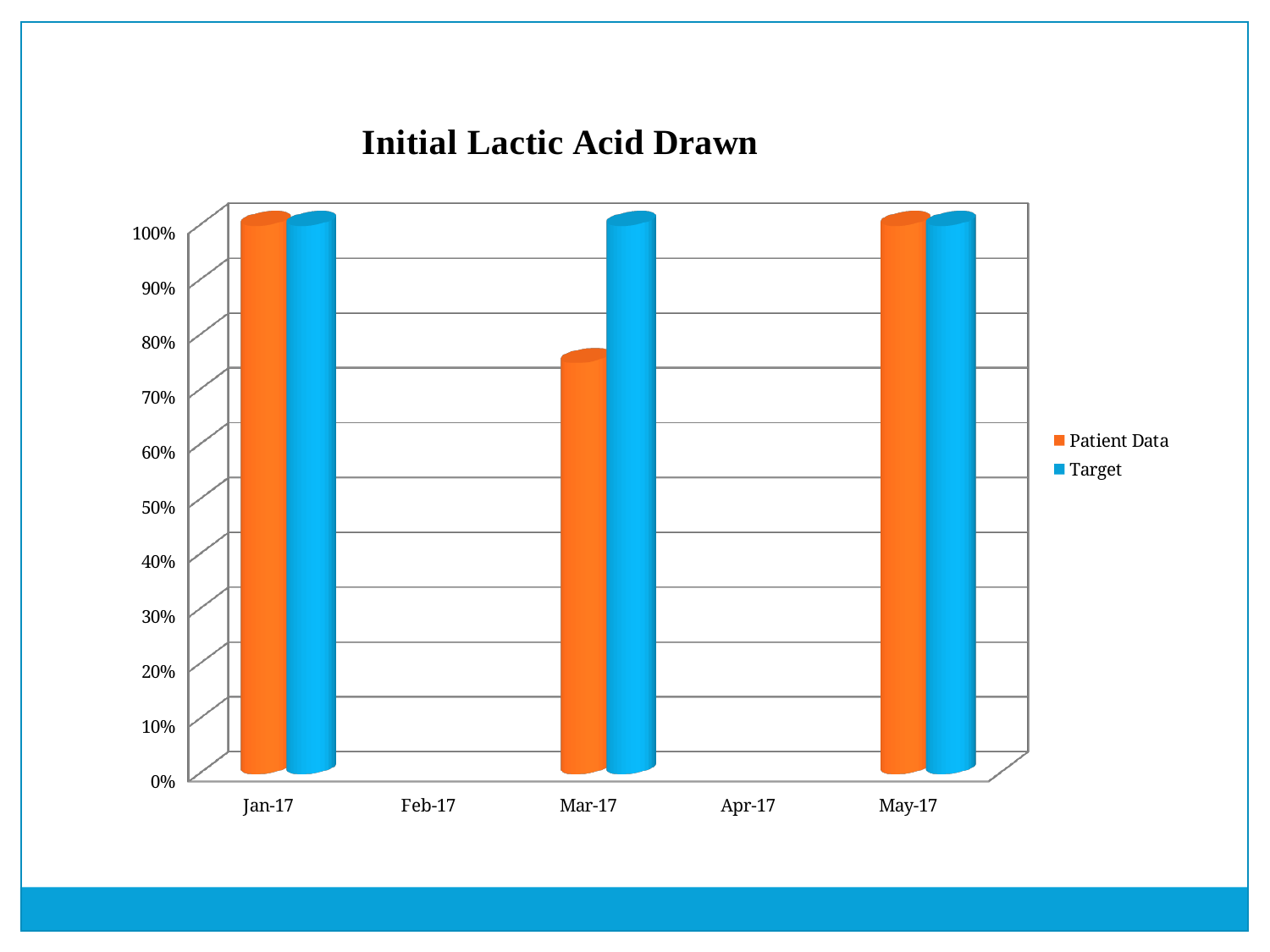
What is the title of the chart? Initial Lactic Acid Drawn Is the Patient Data value for Mar-17 greater or less than 70%? greater How many series does the legend list? 2 For Mar-17, which is larger: Patient Data or Target? Target Which months on the x axis have no bars plotted? Feb-17 and Apr-17 Among the months with bars plotted, which month has the lowest Patient Data value? Mar-17 Which colour represents the Target series? blue What kind of chart is shown on the slide? bar chart How many categories are shown on the x axis? 5 How many months on the x axis have bars plotted? 3 What is the Target value for Mar-17? 100% Is the Patient Data value for Mar-17 greater or less than 80%? less